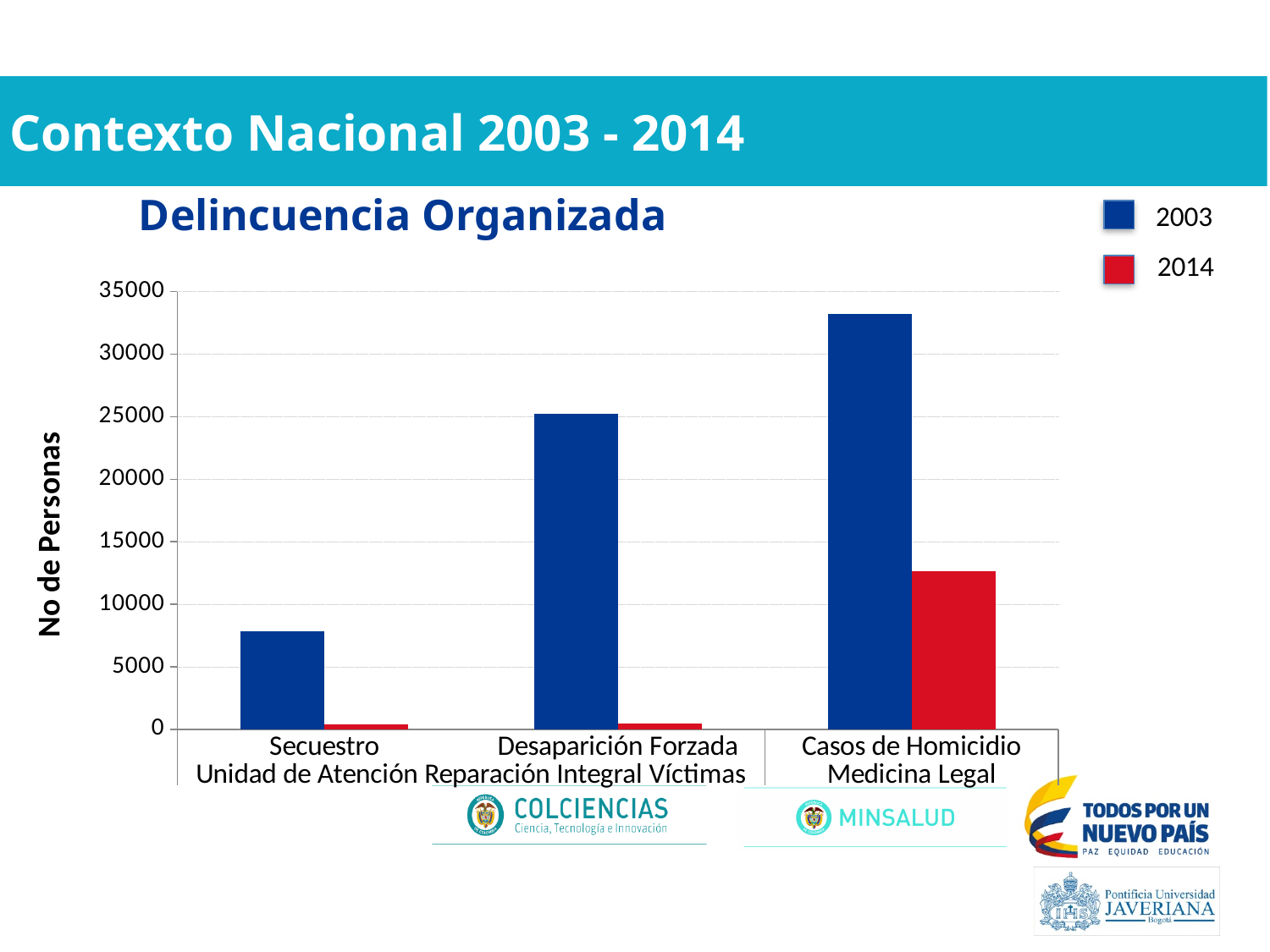
Which category has the lowest value for 2003? Secuestro Is the 2014 value for Casos de Homicidio greater or less than 15000? less Is the 2003 value for Casos de Homicidio greater or less than 30000? greater Which category has the highest value for 2014? Casos de Homicidio What kind of chart is shown on the slide? bar chart Which is larger: the 2003 value for Secuestro or the 2014 value for Casos de Homicidio? 2014 value for Casos de Homicidio How many series does the legend list? 2 Is the 2003 value for Secuestro greater or less than 5000? greater Do the 2003 values rise or fall from Secuestro to Casos de Homicidio along the x axis? rise Which category has the highest value for 2003? Casos de Homicidio How many categories are shown on the x axis? 3